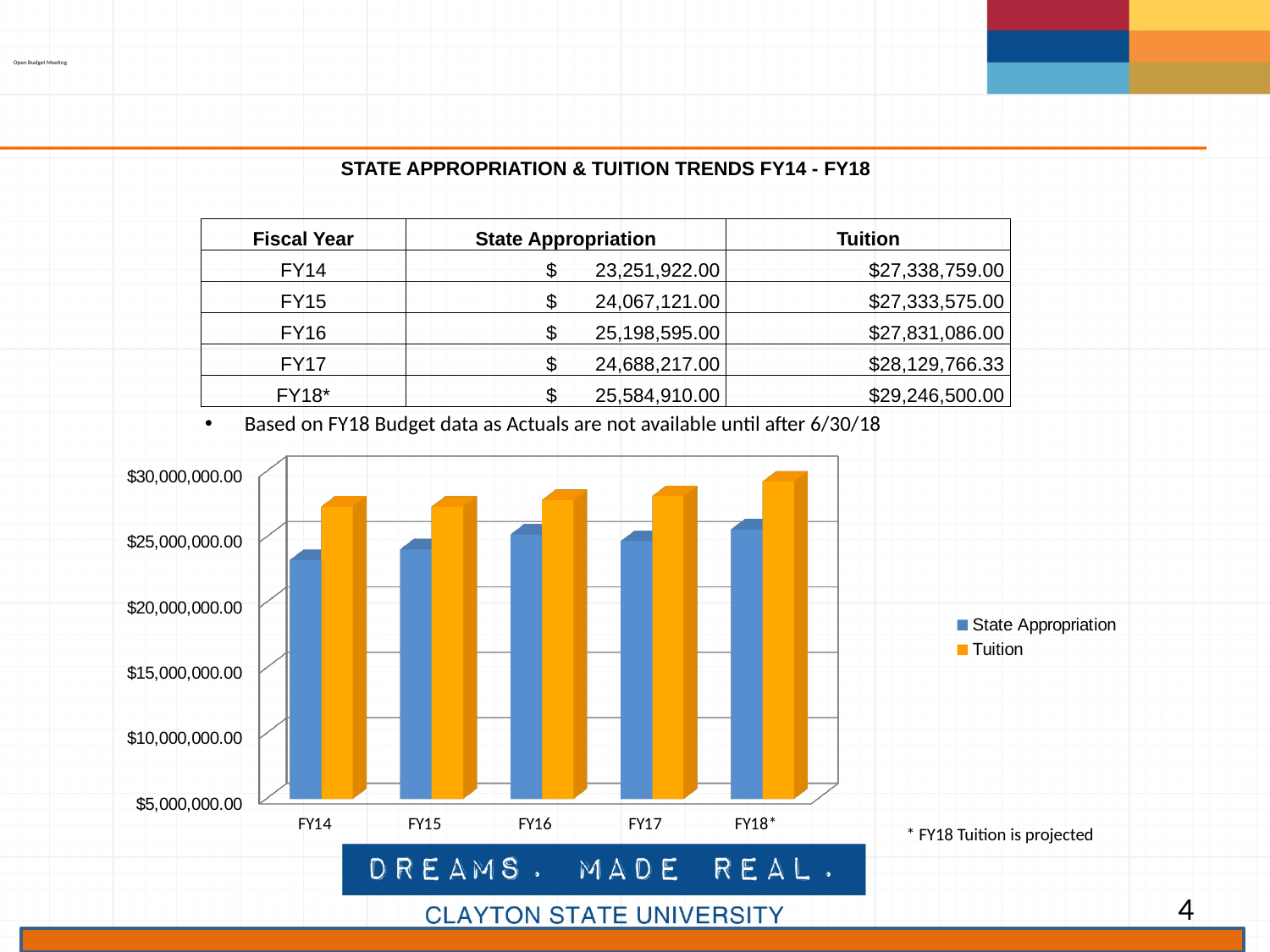
What kind of chart is shown on the slide? Bar chart What is the difference between Tuition and State Appropriation in FY18*? $3,661,590.00 How many series does the chart legend list? 2 How many fiscal years are shown on the x axis of the chart? 5 What is the State Appropriation for FY14? $23,251,922.00 Which fiscal year has the highest Tuition? FY18* What is the Tuition value for FY17? $28,129,766.33 Which is larger in FY16, State Appropriation or Tuition? Tuition Which fiscal year has the lowest State Appropriation? FY14 Which fiscal year has the highest State Appropriation? FY18* What is the Tuition value for FY18*? $29,246,500.00 Is the State Appropriation for FY14 greater or less than $25,000,000.00? less